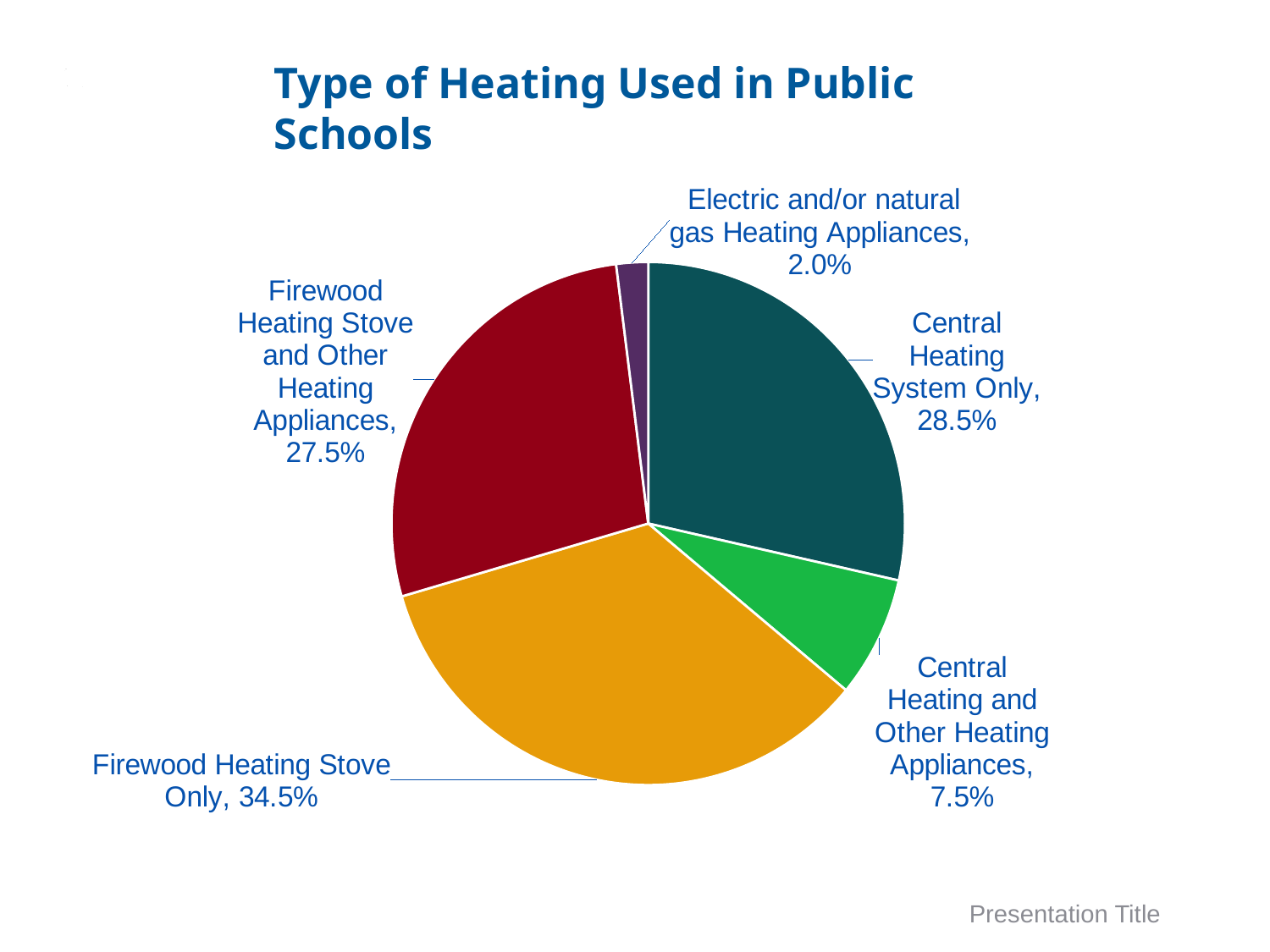
What percentage is shown for Electric and/or natural gas Heating Appliances? 2.0% What is the difference between the shares for Firewood Heating Stove Only and Central Heating System Only? 6.0% What type of chart is shown on the slide? Pie chart What percentage is shown for Central Heating System Only? 28.5% How many slices does the pie chart have? 5 What percentage is shown for Central Heating and Other Heating Appliances? 7.5% Which is larger: the share for Central Heating System Only or the share for Firewood Heating Stove and Other Heating Appliances? Central Heating System Only What share of public schools use a Firewood Heating Stove Only? 34.5% Which heating type has the smallest share of the pie? Electric and/or natural gas Heating Appliances What is the title of the chart? Type of Heating Used in Public Schools Which heating type has the largest share of the pie? Firewood Heating Stove Only What colour is the slice for Firewood Heating Stove Only? Orange